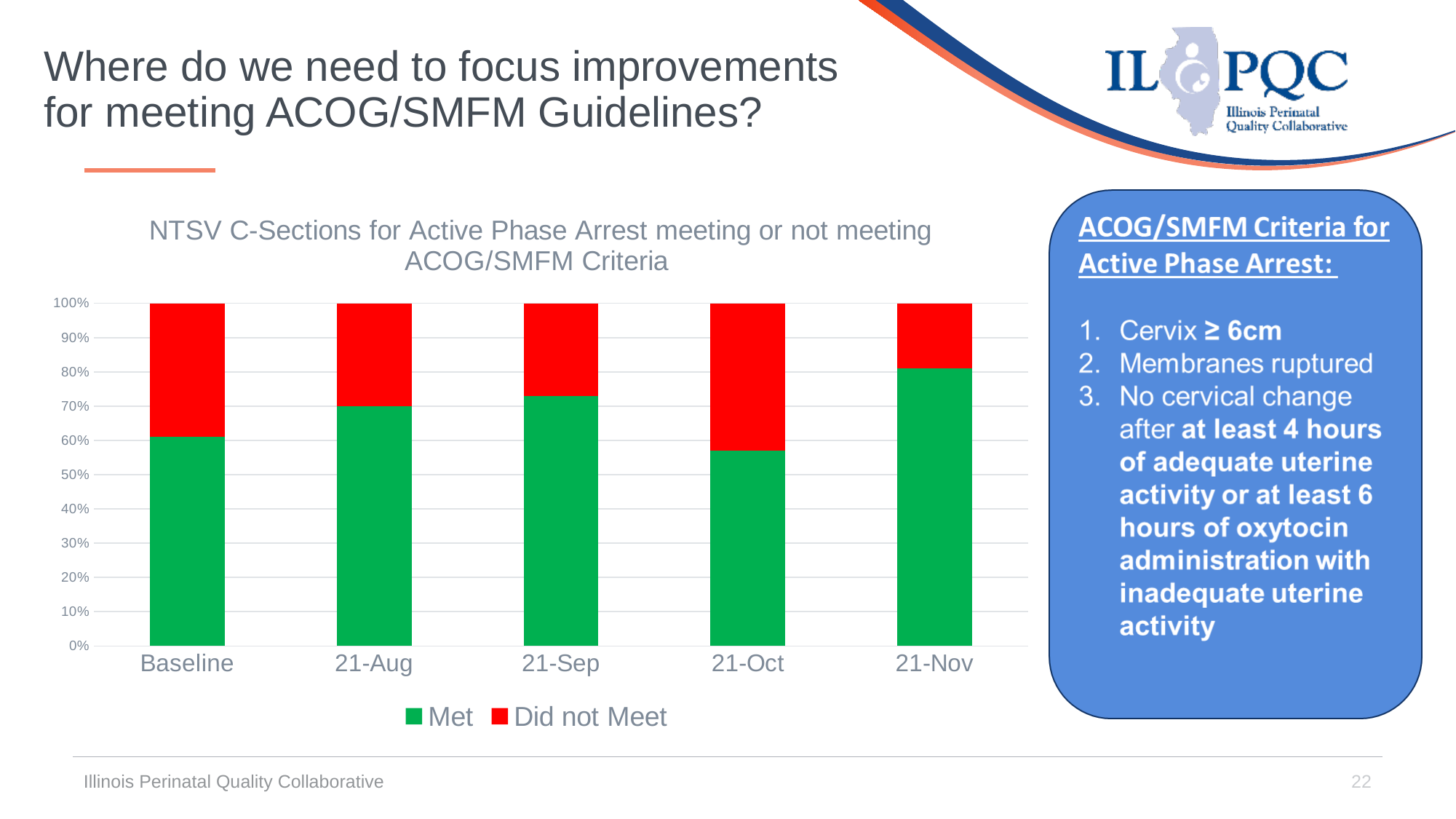
Which category has the highest share of 'Met'? 21-Nov Is the 'Met' share for Baseline greater or less than 70%? less How many series does the chart legend list? 2 Is the 'Met' share for 21-Aug greater or less than 60%? greater What kind of chart is shown on the slide? Stacked bar chart Is the 'Met' share for 21-Oct greater or less than 60%? less Which category has the lowest share of 'Met'? 21-Oct How many categories are shown along the x axis of the chart? 5 Which has a larger 'Met' share, 21-Nov or Baseline? 21-Nov What colour represents the 'Did not Meet' series in the chart? Red Which has a larger 'Did not Meet' share, 21-Oct or 21-Aug? 21-Oct